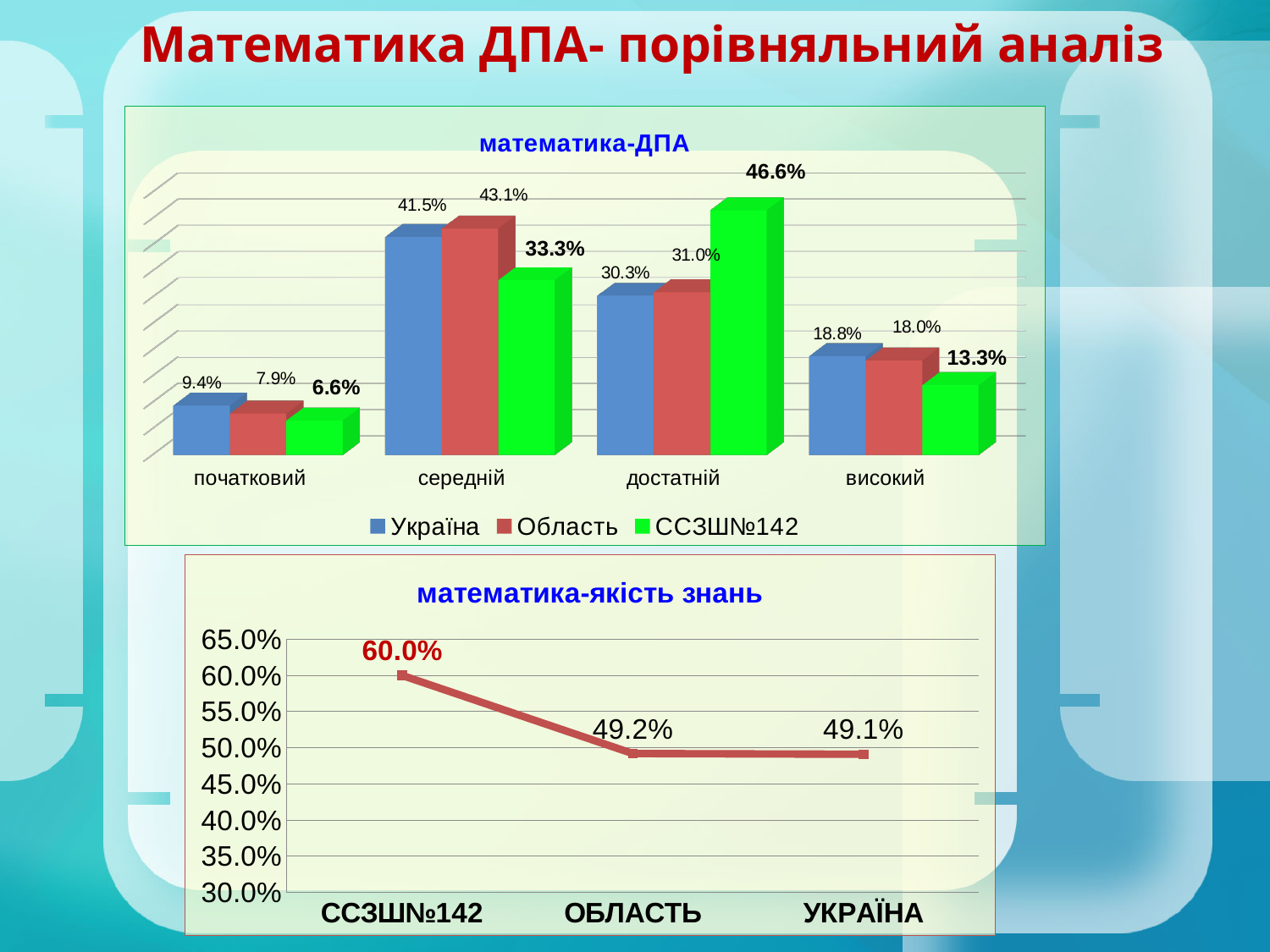
In the chart titled "математика-якість знань", what is the value for ССЗШ№142? 60.0% In the chart titled "математика-ДПА", which category has the lowest value for Україна? початковий In the chart titled "математика-ДПА", which category has the highest value for ССЗШ№142? достатній In the chart titled "математика-ДПА", what is the value for ССЗШ№142 in the достатній category? 46.6% What kind of chart is the one titled "математика-якість знань"? line chart In the chart titled "математика-ДПА", how many series does the legend list? 3 In the chart titled "математика-ДПА", what is the difference between the Область and ССЗШ№142 values in the середній category? 9.8% In the chart titled "математика-ДПА", how many categories are shown on the x axis? 4 In the chart titled "математика-ДПА", what is the value for Область in the високий category? 18.0% In the chart titled "математика-ДПА", which is larger in the початковий category: Україна or ССЗШ№142? Україна In the chart titled "математика-якість знань", what is the difference between the ССЗШ№142 and ОБЛАСТЬ values? 10.8% In the chart titled "математика-ДПА", what is the value for Україна in the середній category? 41.5%